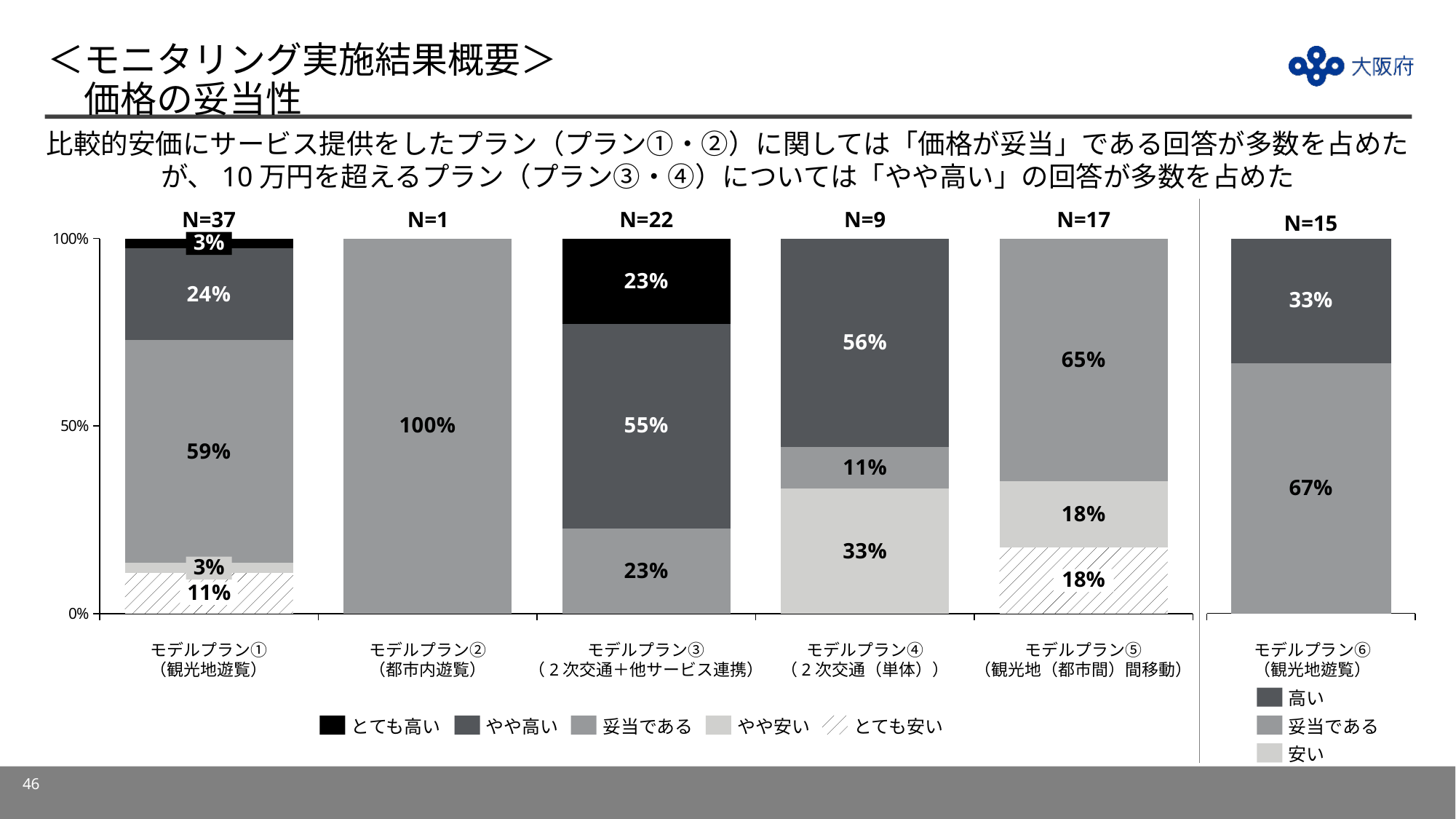
What percentage of respondents for モデルプラン③ answered やや高い? 55% Which model plan has 100% of respondents answering 妥当である? モデルプラン② What is the N (number of respondents) shown for モデルプラン③? N=22 What is the difference between the やや高い share for モデルプラン④ (56%) and the やや高い share for モデルプラン① (24%)? 32% How many model plans (bars) are shown in the chart? 6 How many series does the main legend (below モデルプラン①〜⑤) list? 5 What percentage of respondents for モデルプラン① answered 妥当である? 59% Which legend entry is drawn with a hatched (diagonal line) pattern? とても安い Which is larger for モデルプラン⑤: the share answering 妥当である or the share answering やや安い? 妥当である What kind of chart is shown on the slide? Stacked bar chart What percentage of respondents for モデルプラン④ answered やや安い? 33% What percentage of respondents for モデルプラン⑥ answered 高い? 33%